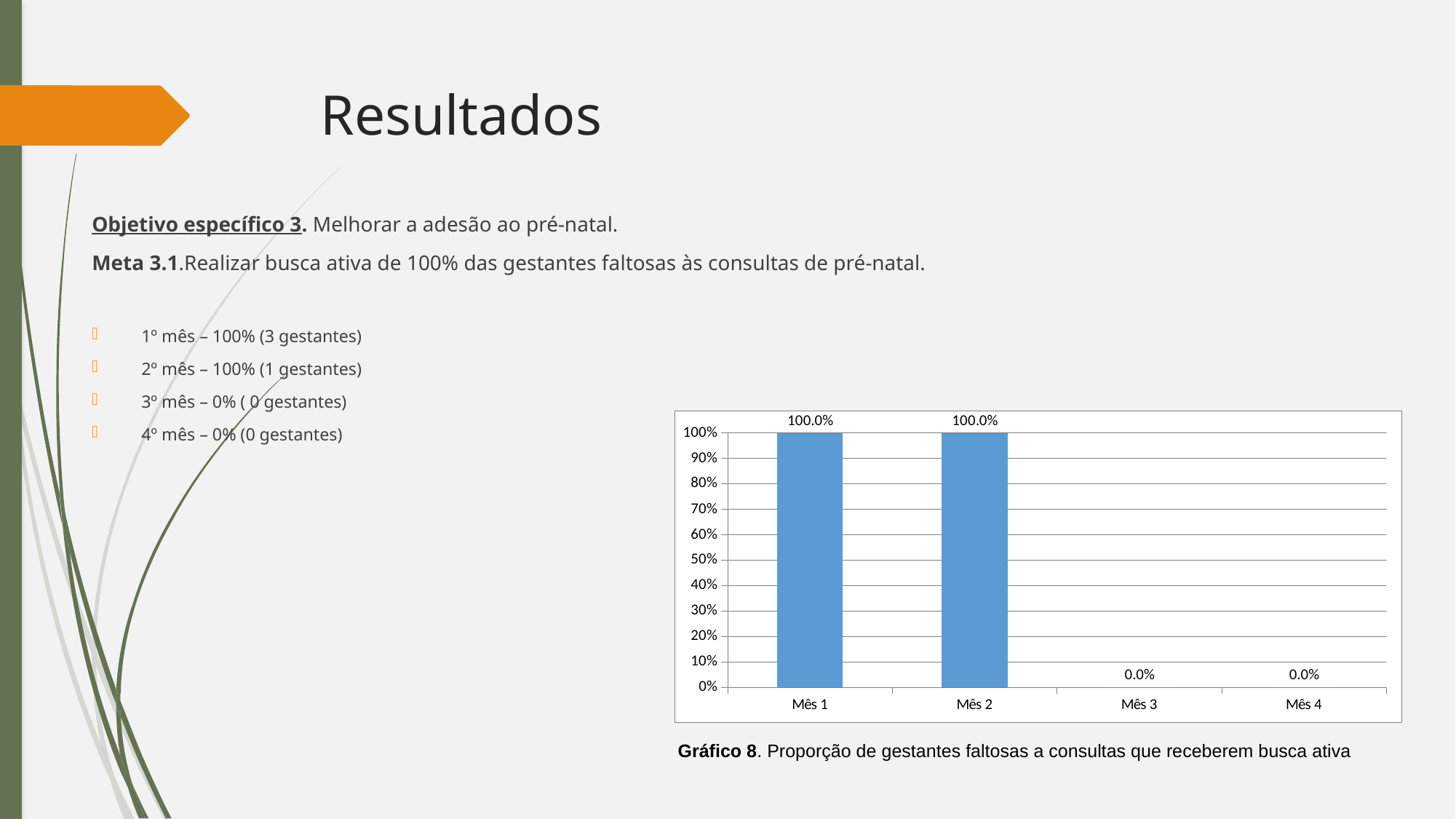
How many months are shown on the x axis of the chart? 4 Which month has the lowest value, Mês 2 or Mês 3? Mês 3 Do the values rise or fall from Mês 2 to Mês 3? fall What is the difference between the values for Mês 1 and Mês 4? 100.0% Is the value for Mês 2 greater or less than 50%? greater What is the value for Mês 2? 100.0% What is the caption of the chart on the slide? Gráfico 8. Proporção de gestantes faltosas a consultas que receberem busca ativa What is the value for Mês 1? 100.0% What is the value for Mês 4? 0.0% What is the value for Mês 3? 0.0% What colour are the bars in the chart? blue What kind of chart is shown on the slide? bar chart